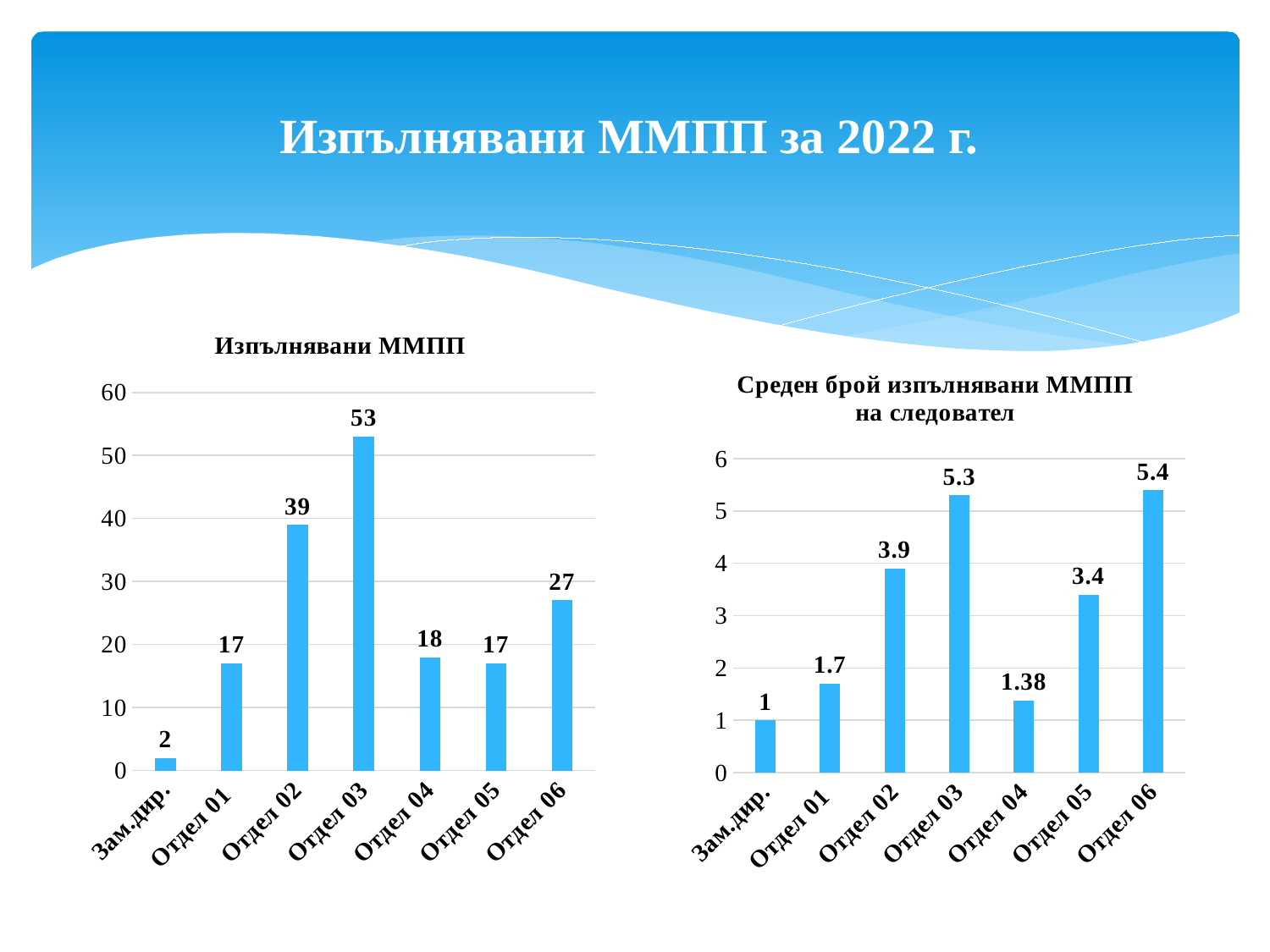
In the chart titled "Среден брой изпълнявани ММПП на следовател", what is the difference between Отдел 03 and Зам.дир.? 4.3 In the chart titled "Среден брой изпълнявани ММПП на следовател", what is the value for Отдел 01? 1.7 In the chart titled "Среден брой изпълнявани ММПП на следовател", which is larger, the value for Отдел 02 or Отдел 05? Отдел 02 In the chart titled "Изпълнявани ММПП", what is the difference between Отдел 02 and Отдел 06? 12 In the chart titled "Среден брой изпълнявани ММПП на следовател", which category has the highest value? Отдел 06 In the chart titled "Изпълнявани ММПП", how many categories are shown on the x axis? 7 In the chart titled "Изпълнявани ММПП", which is larger, the value for Отдел 04 or Отдел 06? Отдел 06 In the chart titled "Среден брой изпълнявани ММПП на следовател", what is the value for Отдел 04? 1.38 In the chart titled "Изпълнявани ММПП", which category has the lowest value? Зам.дир. What is the title of the chart on the right side of the slide? Среден брой изпълнявани ММПП на следовател What kind of chart is the chart titled "Изпълнявани ММПП"? Bar chart In the chart titled "Изпълнявани ММПП", what is the value for Отдел 03? 53